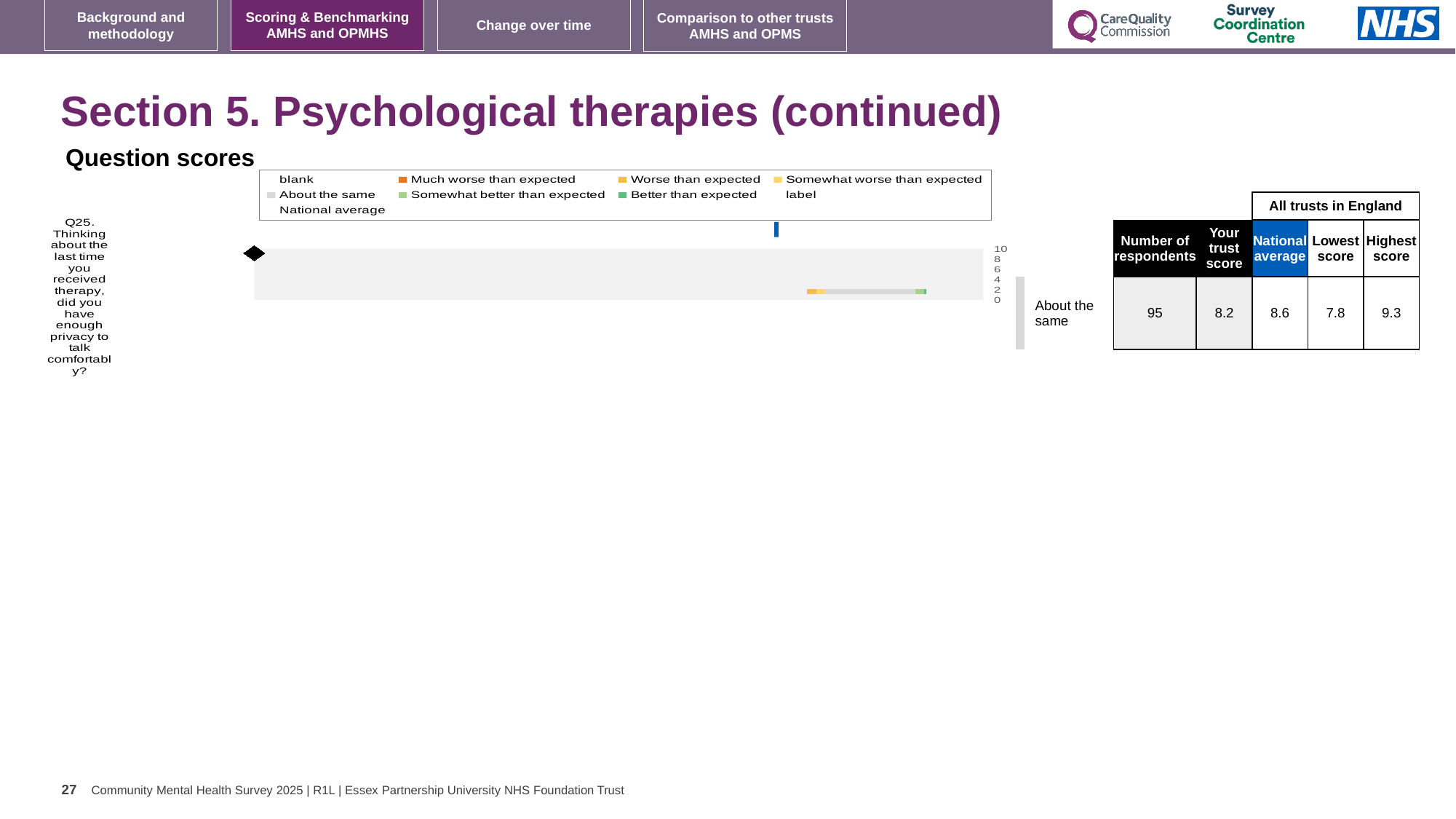
For Q25, what is the difference between the highest score and the lowest score among all trusts in England? 1.5 How many respondents are shown for Q25 in the table beside the chart? 95 What is the 'Your trust score' value for Q25? 8.2 Which question number is plotted in the Question scores chart? Q25 How many survey questions are plotted in the Question scores chart? 1 What is the lowest score among all trusts in England for Q25? 7.8 What is the highest score among all trusts in England for Q25? 9.3 What is the national average score for Q25? 8.6 For Q25, which is larger: the trust score or the national average? National average What benchmark category is shown for Q25 next to the chart? About the same What kind of chart is shown under 'Question scores'? bar chart What is the highest tick value shown on the chart's score axis? 10